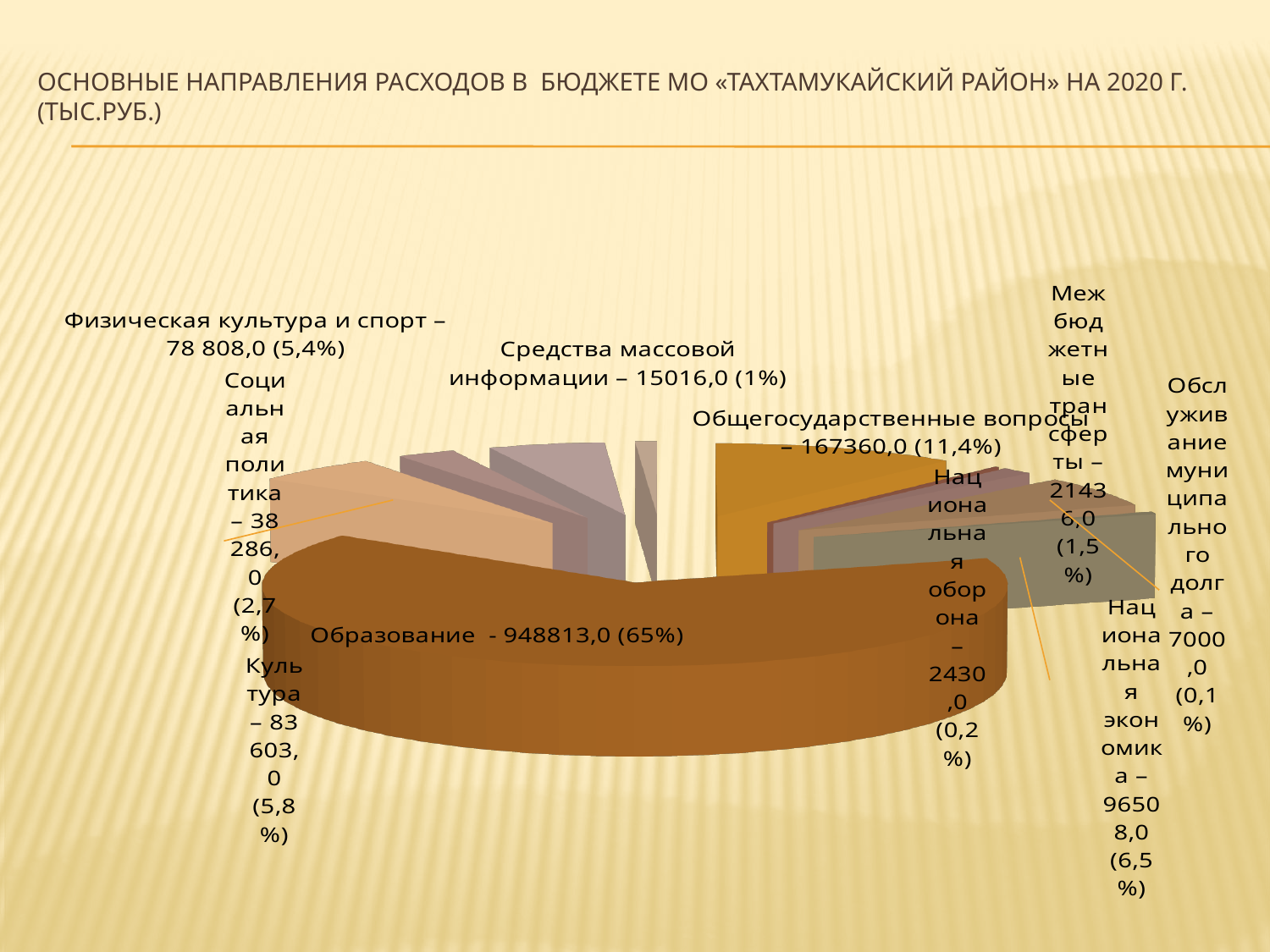
Which category has the largest expenditure? Образование What share of the budget does Национальная экономика account for? 6,5% Which category has the smallest expenditure? Национальная оборона What kind of chart is shown on the slide? Pie chart What share of the budget does Образование account for? 65% What is the value for Образование? 948813,0 How many expenditure categories are shown in the chart? 10 Which is larger: Культура or Физическая культура и спорт? Культура What is the difference between Общегосударственные вопросы and Национальная экономика? 70852,0 What is the value for Общегосударственные вопросы? 167360,0 What is the value for Физическая культура и спорт? 78 808,0 What is the value for Обслуживание муниципального долга? 7000,0